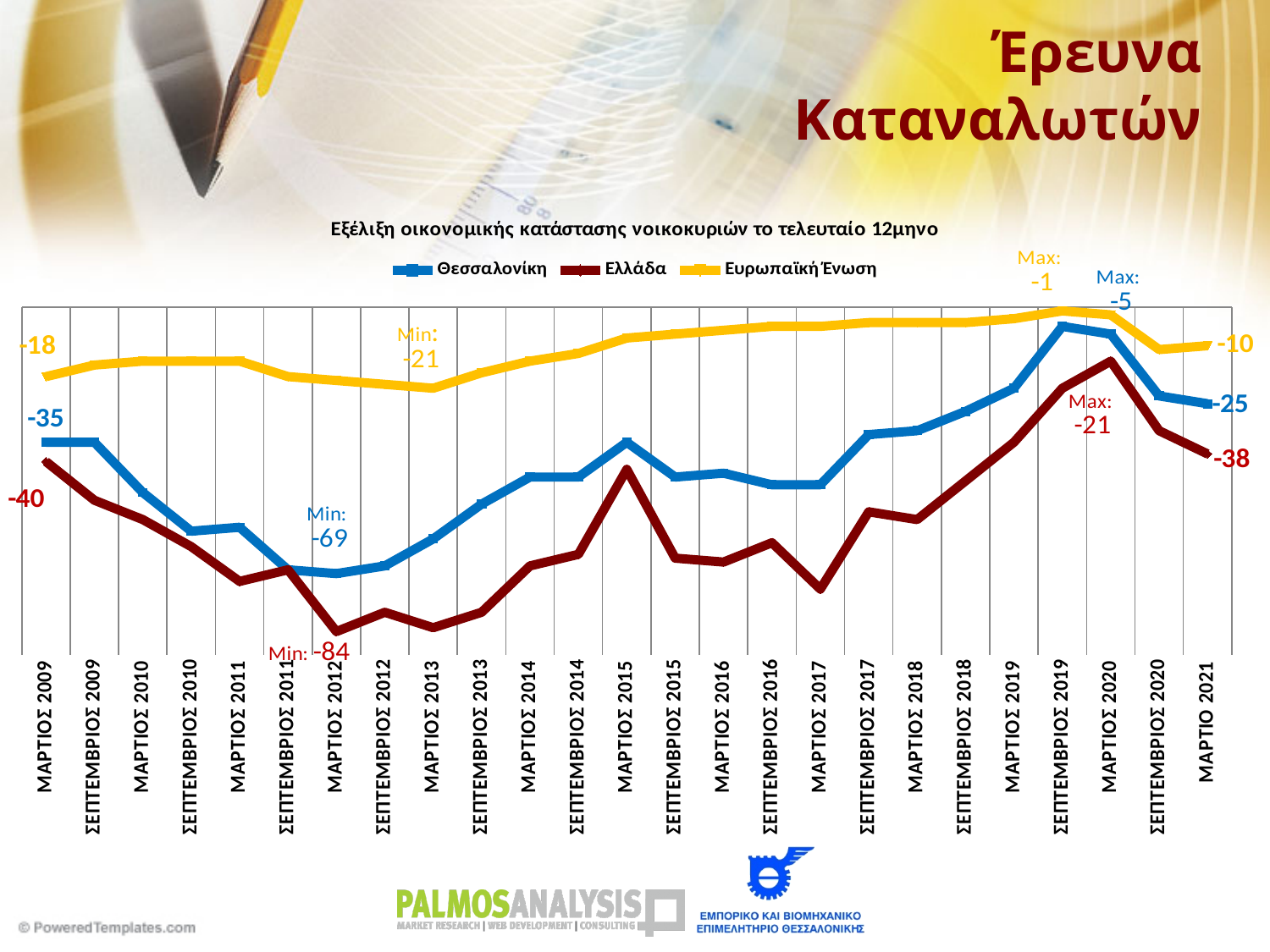
What type of chart is shown on the slide? line chart What is the value for Θεσσαλονίκη at ΜΑΡΤΙΟ 2021? -25 What is the title of the chart? Εξέλιξη οικονομικής κατάστασης νοικοκυριών το τελευταίο 12μηνο What is the minimum value reached by the Ελλάδα series? -84 What is the maximum value reached by the Θεσσαλονίκη series? -5 How many series does the legend list? 3 What is the value for Ελλάδα at ΜΑΡΤΙΟ 2021? -38 What is the value for Ευρωπαϊκή Ένωση at ΜΑΡΤΙΟΣ 2009? -18 How many time points are plotted along the x axis? 25 Does the Θεσσαλονίκη series rise or fall between ΜΑΡΤΙΟΣ 2012 and ΜΑΡΤΙΟΣ 2015? rise At ΜΑΡΤΙΟΣ 2009, which is higher: Θεσσαλονίκη or Ελλάδα? Θεσσαλονίκη What is the difference between the Ευρωπαϊκή Ένωση value and the Ελλάδα value at ΜΑΡΤΙΟ 2021? 28